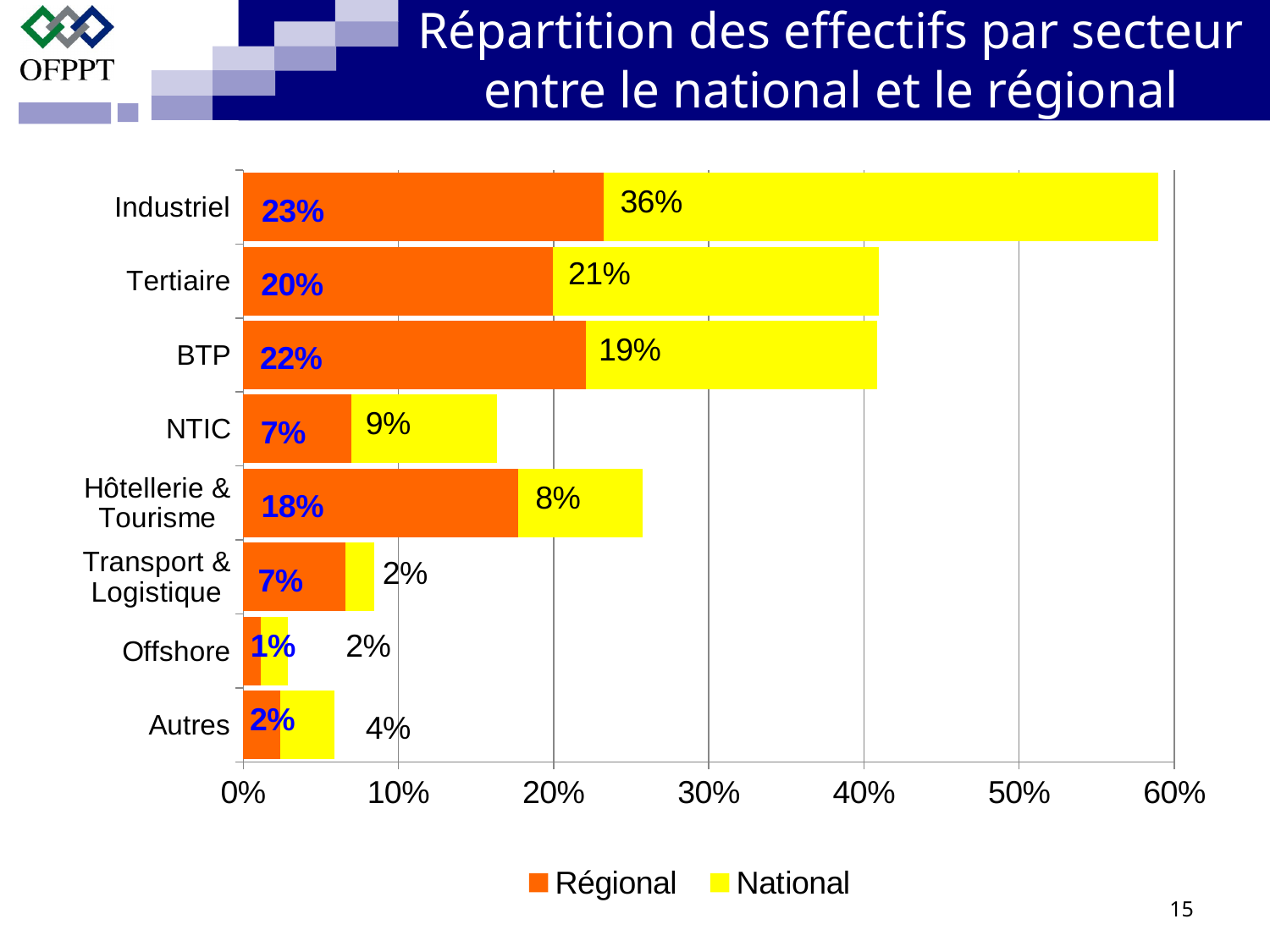
Which sector has the highest National value? Industriel What is the difference between the National and Régional values for Industriel? 13% What is the total of the stacked bar for Industriel? 59% Which is larger for Hôtellerie & Tourisme, the Régional value or the National value? Régional How many sectors are shown on the chart? 8 How many series does the legend list? 2 What kind of chart is shown on the slide? Stacked bar chart What is the National value for BTP? 19% What is the Régional value for Industriel? 23% Which sector has the lowest Régional value? Offshore What is the Régional value for Transport & Logistique? 7% What is the National value for Hôtellerie & Tourisme? 8%